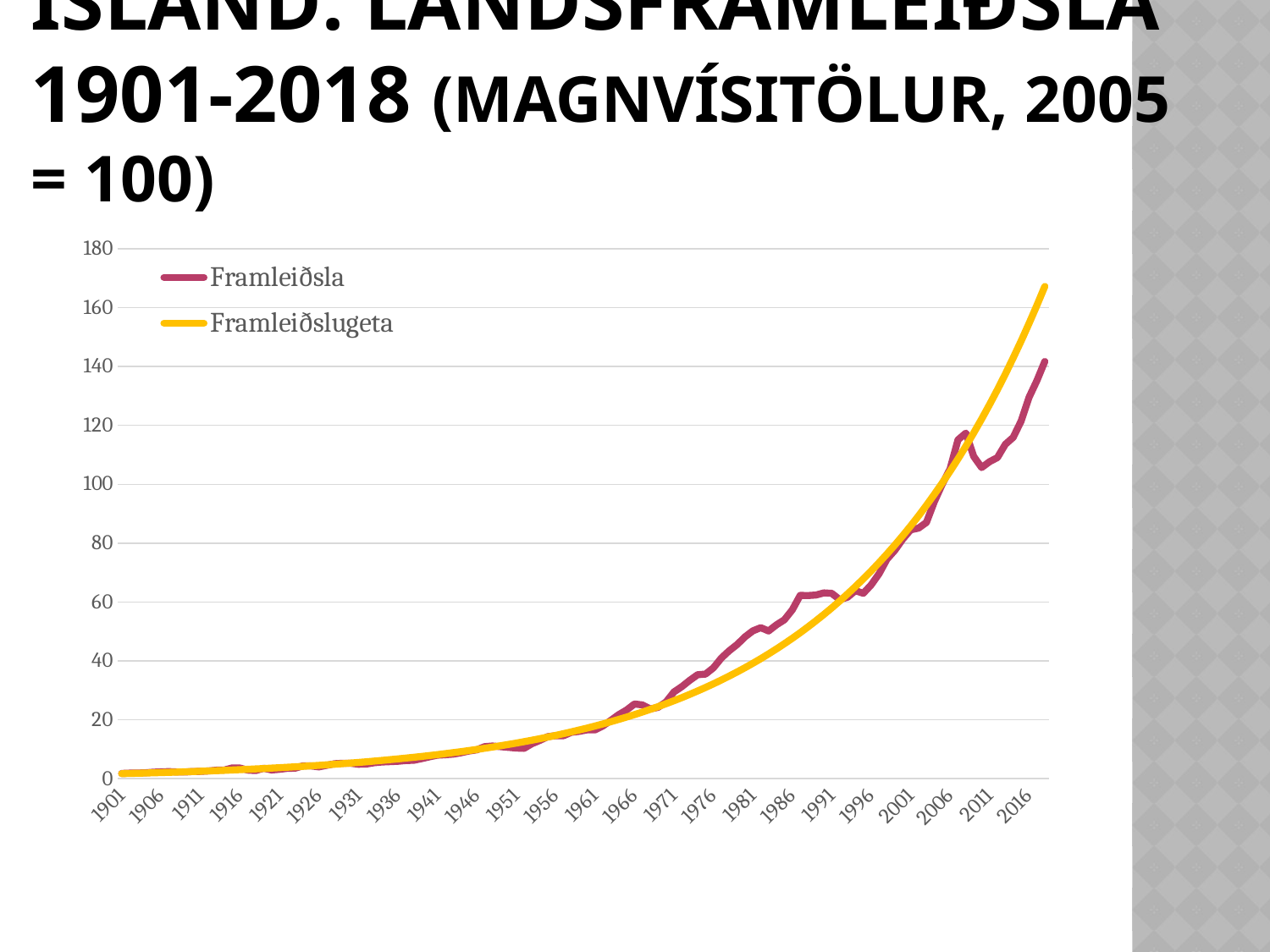
What kind of chart is shown on the slide? line chart At the right-hand end of the chart, which series has the higher value, Framleiðsla or Framleiðslugeta? Framleiðslugeta Which colour is used for the Framleiðslugeta line? yellow What is the highest value shown on the vertical axis? 180 What are the two series named in the legend? Framleiðsla and Framleiðslugeta Is the final value of the Framleiðsla line greater or less than 120? greater In 1986, which series has the higher value, Framleiðsla or Framleiðslugeta? Framleiðsla Does the Framleiðslugeta line rise or fall from 1901 to the end of the series? rise How many series does the legend list? 2 Is the final value of the Framleiðslugeta line greater or less than 160? greater Is the value of Framleiðsla in 1901 greater or less than 20? less